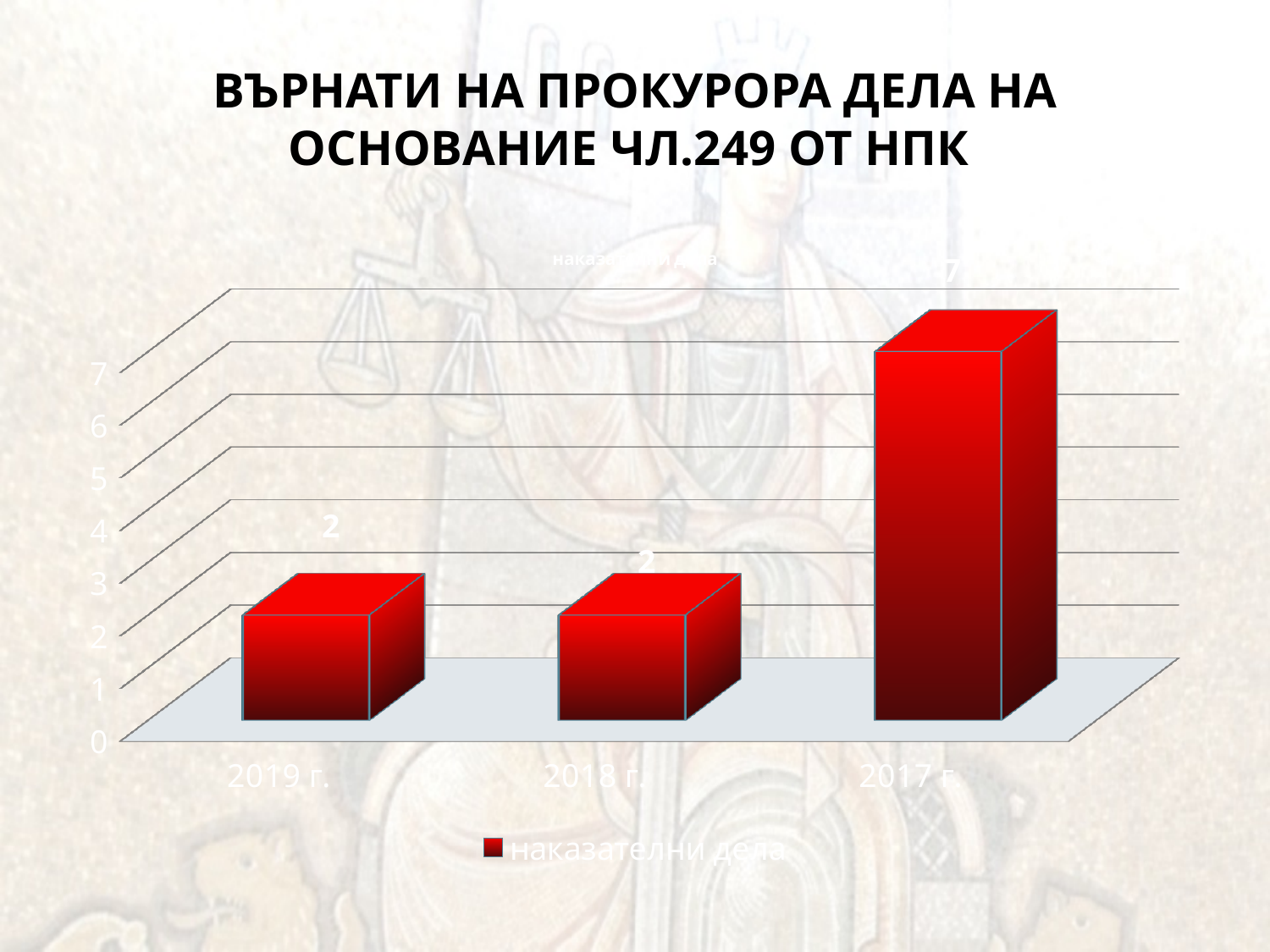
What kind of chart is shown on the slide? bar chart What is the difference between the values for 2017 г. and 2018 г.? 5 Which year has the highest value? 2017 г. Is the value for 2019 г. greater or less than 4? less What is the legend entry of the series shown in the chart? наказателни дела What is the value for 2017 г.? 7 Is the value for 2017 г. greater or less than 5? greater What is the value for 2019 г.? 2 How many series does the legend list? 1 What is the value for 2018 г.? 2 Which is larger, the value for 2017 г. or the value for 2019 г.? 2017 г. How many categories are shown on the x axis? 3